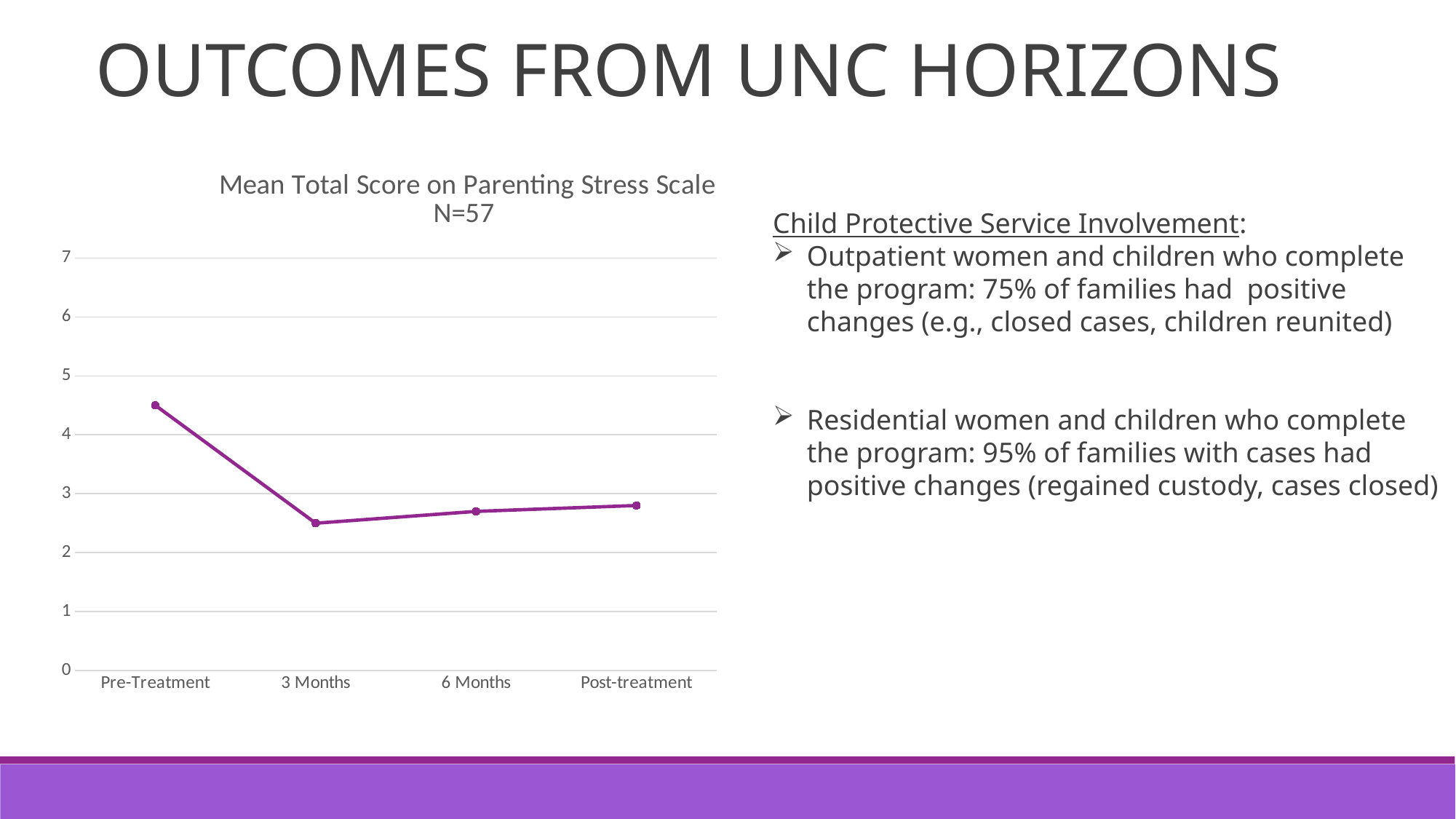
What sample size (N) is stated in the chart title? N=57 Is the value for Post-treatment greater or less than 3? less Which time point has the lowest mean total score on the Parenting Stress Scale? 3 Months What is the title of the chart? Mean Total Score on Parenting Stress Scale N=57 Is the value for 6 Months greater or less than 2? greater Is the value for 3 Months greater or less than 3? less How many time points are plotted on the chart? 4 Which is larger, the value for Pre-Treatment or the value for Post-treatment? Pre-Treatment What kind of chart is shown on the slide? Line chart Which time point has the highest mean total score on the Parenting Stress Scale? Pre-Treatment Does the mean total score rise or fall from Pre-Treatment to 3 Months? Fall